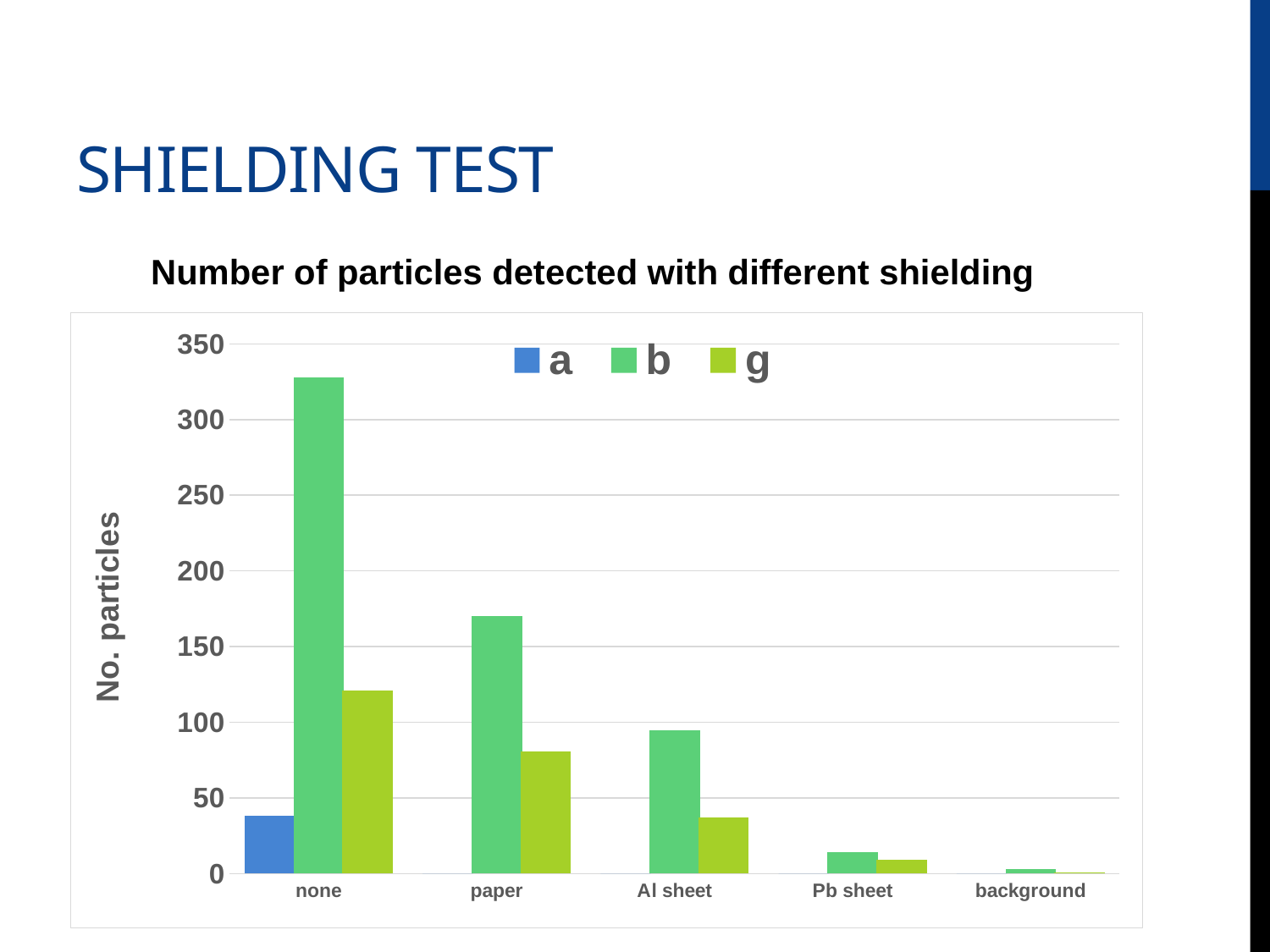
How many series does the legend list? 3 For the paper shielding category, which series has the larger value, b or g? b Do the values for series b rise or fall moving from 'none' to 'background' along the x axis? fall Which shielding category has the highest value for series b? none Is the value for series g with paper shielding greater or less than 100? less Is the value for series a with no shielding (none) greater or less than 50? less What kind of chart is shown on the slide? bar chart Is the value for series b with no shielding (none) greater or less than 300? greater How many shielding categories are shown on the x axis? 5 Which shielding category has the lowest value for series b? background